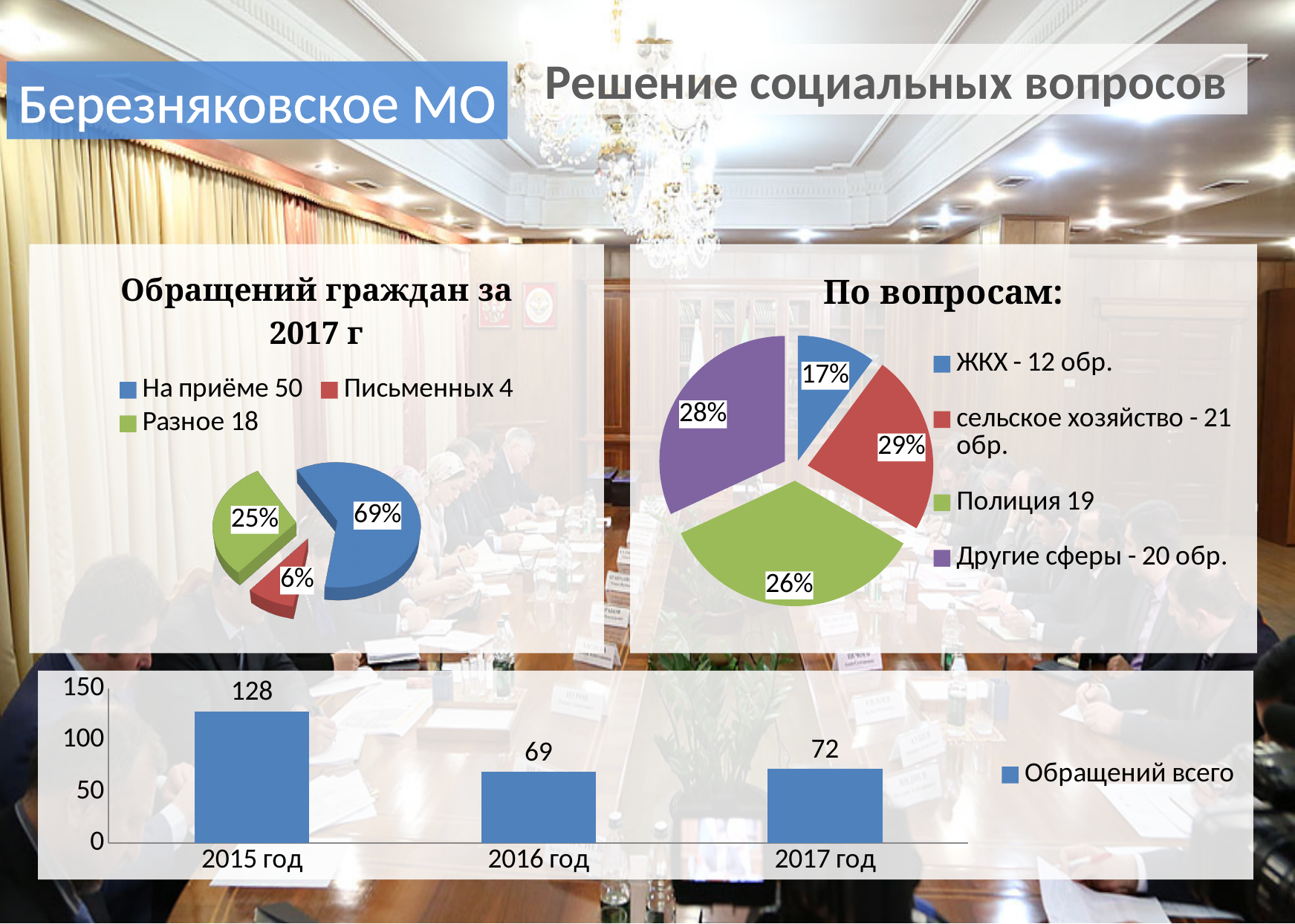
In the pie chart 'По вопросам:', what share does 'сельское хозяйство - 21 обр.' have? 29% In the bar chart at the bottom of the slide, what is the value for 2015 год? 128 In the bar chart at the bottom of the slide, what is the value for 2017 год? 72 What type of chart is shown at the bottom of the slide? bar chart In the bar chart at the bottom of the slide, how many bars are there? 3 In the bar chart at the bottom of the slide, what is the name of the series in the legend? Обращений всего In the bar chart at the bottom of the slide, what is the difference between the values for 2015 год and 2016 год? 59 In the bar chart at the bottom of the slide, which year has the lowest value? 2016 год In the pie chart 'Обращений граждан за 2017 г', which category has the smallest slice? Письменных 4 In the pie chart 'По вопросам:', how many categories does the legend list? 4 In the pie chart 'Обращений граждан за 2017 г', what share does 'На приёме 50' have? 69% In the pie chart 'По вопросам:', which category has the smallest slice? ЖКХ - 12 обр.